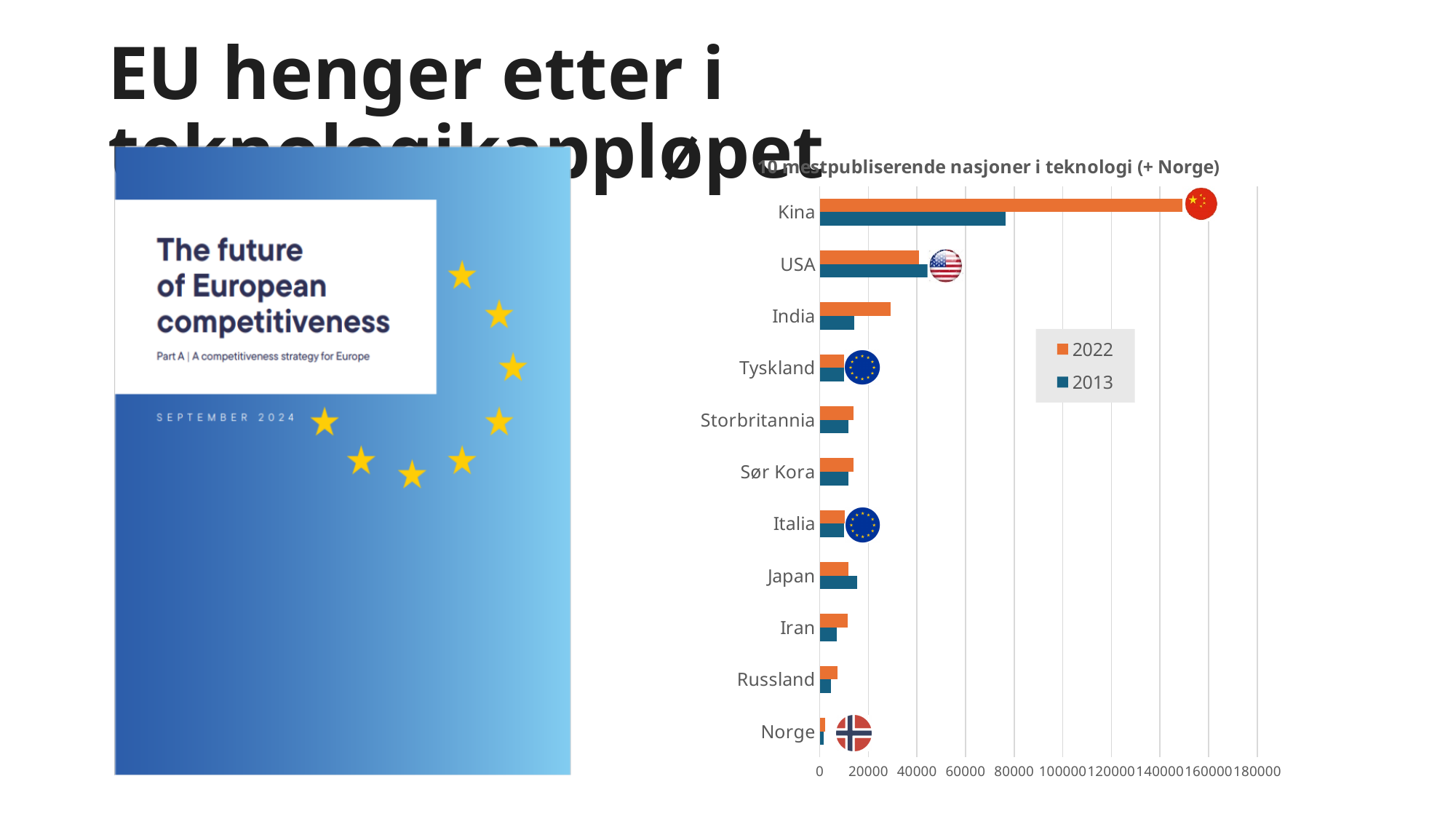
Is the 2013 value for Japan greater or less than 20000? less For USA, which series has the larger value, 2022 or 2013? 2013 How many countries are shown on the chart? 11 Is the 2022 value for India greater or less than 20000? greater Which country has the highest value for 2013? Kina Is the 2013 value for Kina greater or less than 80000? less Which country has the lowest value for 2022? Norge Which country has the highest value for 2022? Kina What kind of chart is shown on the slide? bar chart Which colour represents the 2022 series in the chart? orange How many series does the chart legend list? 2